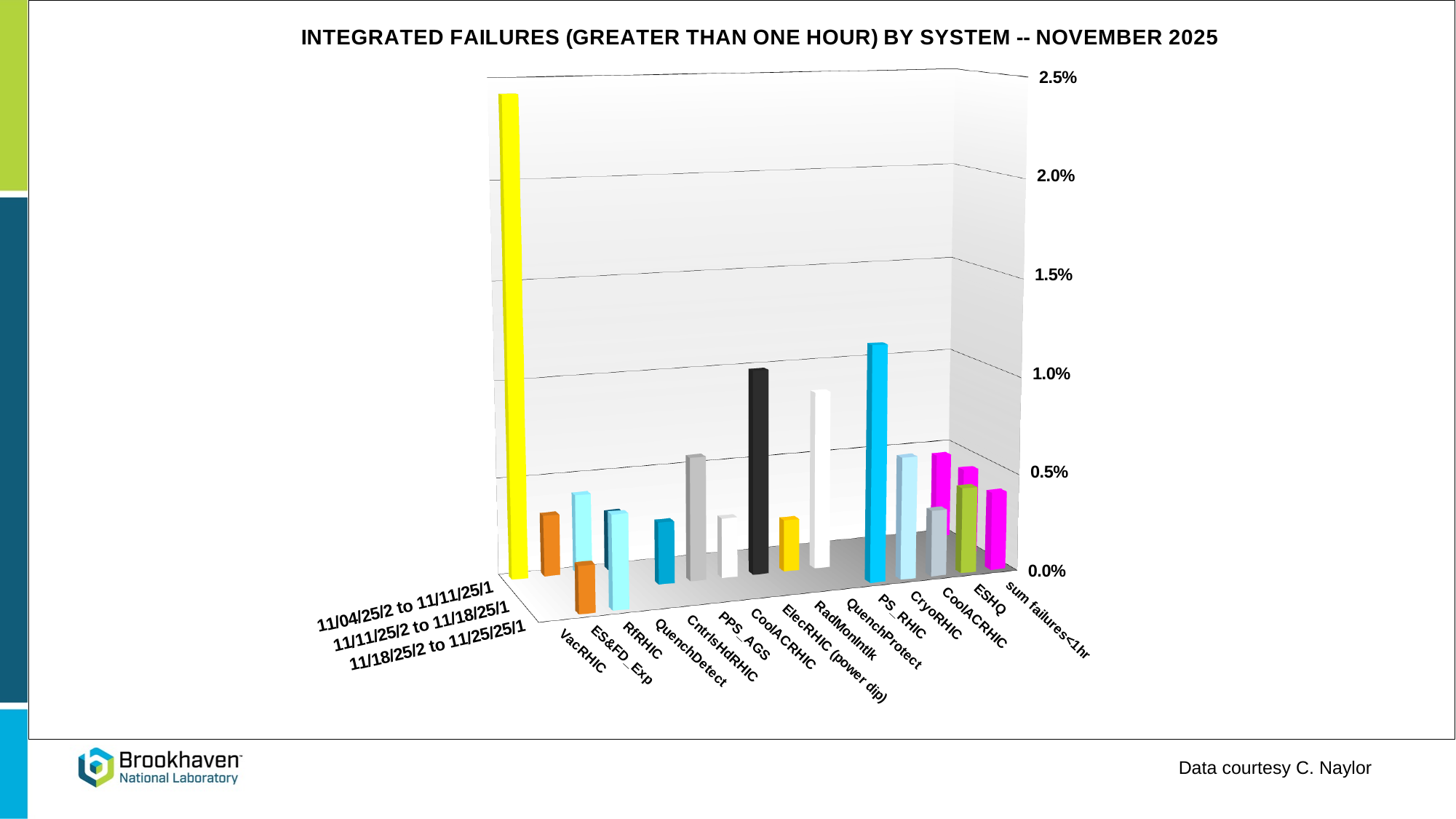
What kind of chart is shown on the slide? bar chart How many date-range series are listed on the depth axis of the chart? 3 How many system categories are listed along the x axis of the chart? 15 What is the last date range listed on the depth axis? 11/18/25/2 to 11/25/25/1 What is the last category listed on the x axis? sum failures<1hr Is the tallest bar in the chart greater or less than 2.0%? greater What is the title of the chart? INTEGRATED FAILURES (GREATER THAN ONE HOUR) BY SYSTEM -- NOVEMBER 2025 What is the first system category listed on the x axis? VacRHIC What is the lowest tick value on the vertical axis? 0.0% What is the first date range listed on the depth axis? 11/04/25/2 to 11/11/25/1 What is the highest value shown on the vertical axis of the chart? 2.5%